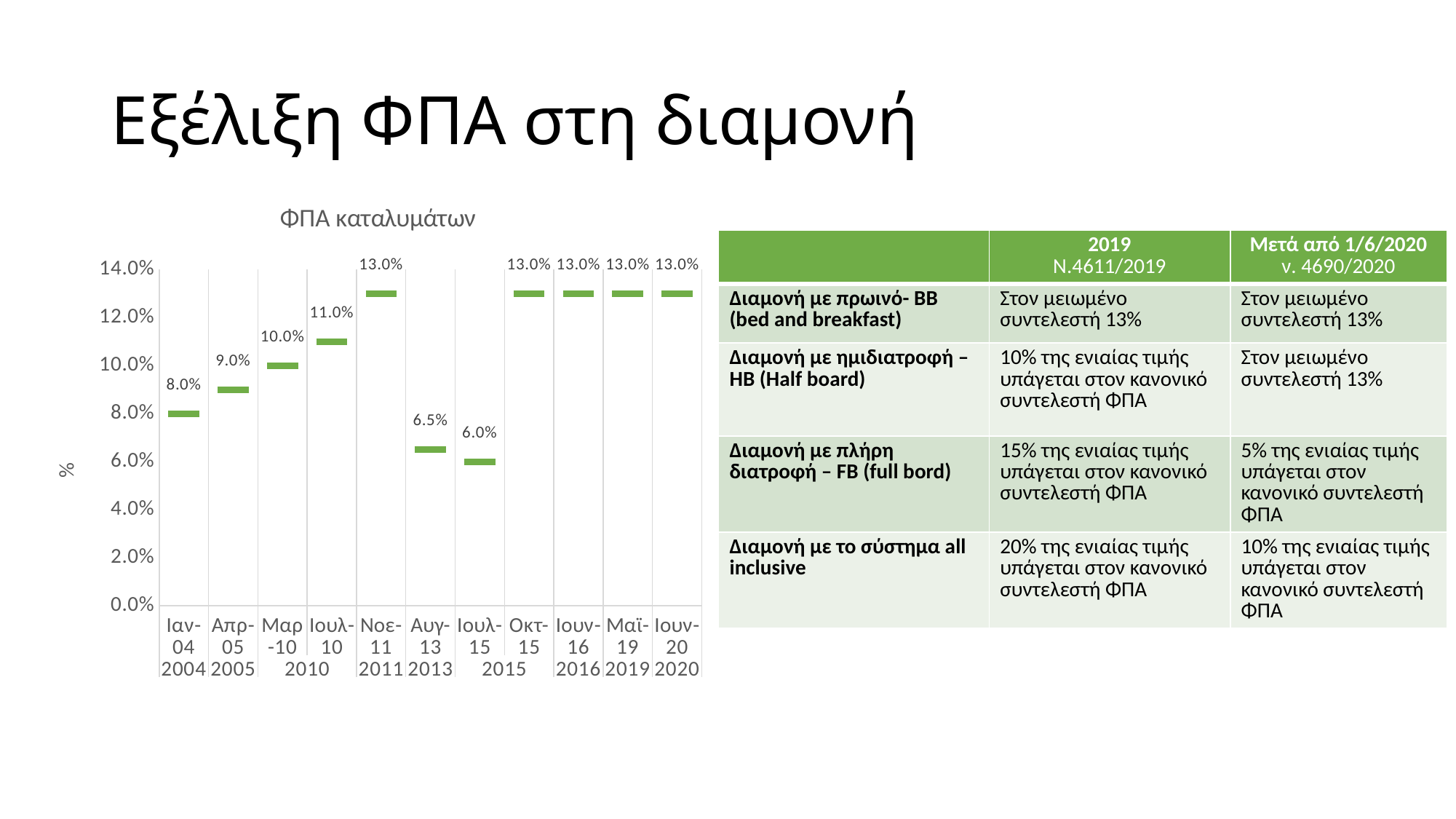
What is the value for Ιουλ-10 2010 in the ΦΠΑ καταλυμάτων chart? 11.0% Do the values in the ΦΠΑ καταλυμάτων chart rise or fall from Ιαν-04 2004 to Νοε-11 2011? rise Is the value for Ιουλ-15 2015 in the ΦΠΑ καταλυμάτων chart greater or less than 8.0%? less How many categories are shown on the x axis of the ΦΠΑ καταλυμάτων chart? 11 What is the title of the chart on the slide? ΦΠΑ καταλυμάτων What is the value for Ιουν-20 2020 in the ΦΠΑ καταλυμάτων chart? 13.0% What is the difference between the values for Νοε-11 2011 and Αυγ-13 2013 in the ΦΠΑ καταλυμάτων chart? 6.5% What is the value for Ιαν-04 2004 in the ΦΠΑ καταλυμάτων chart? 8.0% What is the value for Αυγ-13 2013 in the ΦΠΑ καταλυμάτων chart? 6.5% Which is larger in the ΦΠΑ καταλυμάτων chart: the value for Μαρ-10 2010 or the value for Ιουλ-15 2015? Μαρ-10 2010 What is the difference between the values for Απρ-05 2005 and Ιαν-04 2004 in the ΦΠΑ καταλυμάτων chart? 1.0% Which category has the lowest value in the ΦΠΑ καταλυμάτων chart? Ιουλ-15 2015